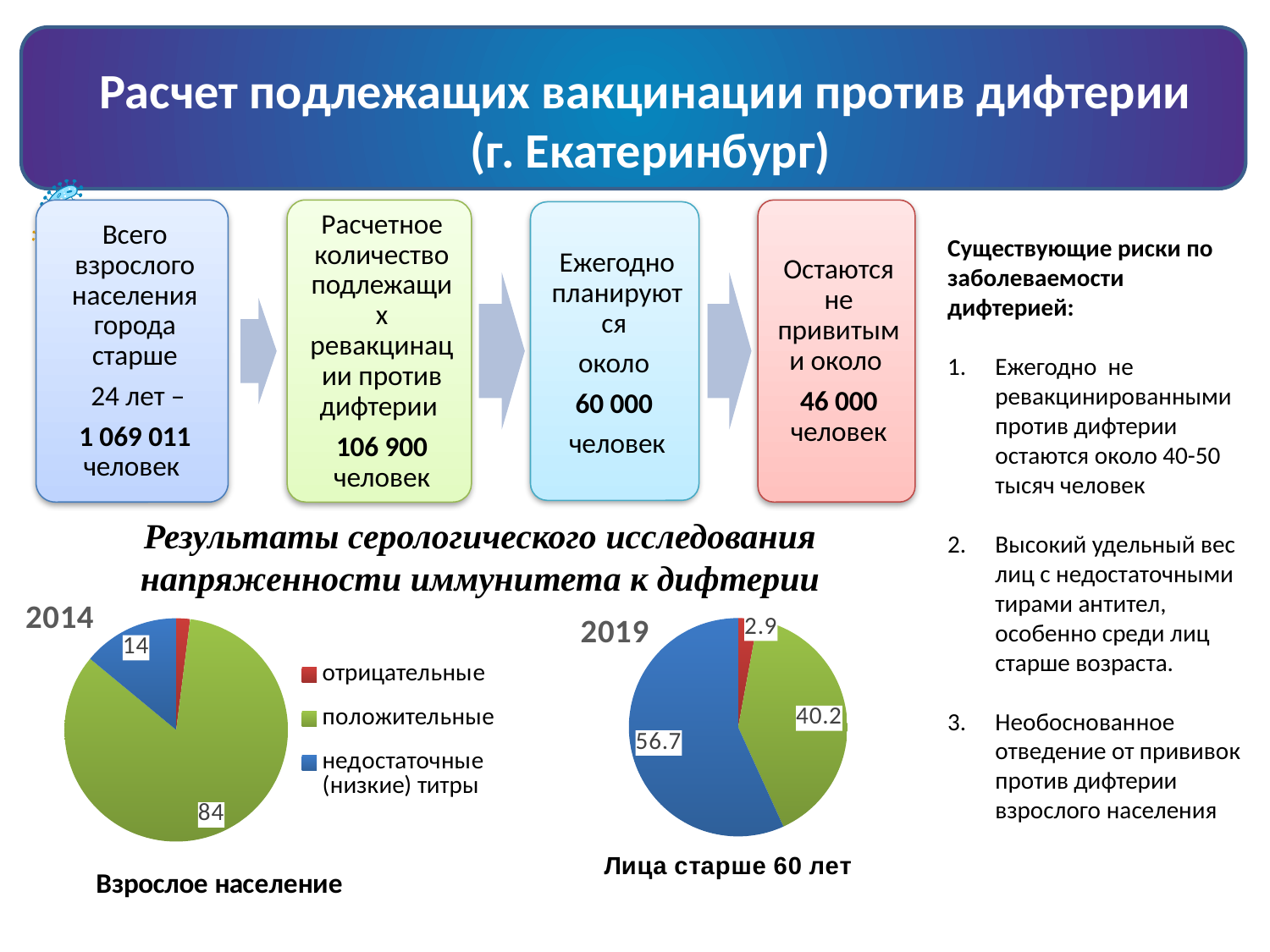
In the 2019 pie chart (Лица старше 60 лет), what value is shown for недостаточные (низкие) титры? 56.7 In the 2014 pie chart (Взрослое население), what value is shown for недостаточные (низкие) титры? 14 In the 2019 pie chart (Лица старше 60 лет), what value is shown for отрицательные? 2.9 Which is larger in the 2019 pie chart (Лица старше 60 лет): положительные or отрицательные? положительные In the 2014 pie chart (Взрослое население), what is the difference between the values for положительные and недостаточные (низкие) титры? 70 How many categories does the legend of the pie charts list? 3 In the 2014 pie chart (Взрослое население), what value is shown for положительные? 84 In the 2019 pie chart (Лица старше 60 лет), what is the difference between the values for недостаточные (низкие) титры and положительные? 16.5 In the 2019 pie chart (Лица старше 60 лет), what value is shown for положительные? 40.2 In the 2019 pie chart (Лица старше 60 лет), which category has the largest slice? недостаточные (низкие) титры What type of chart is used for the 2014 and 2019 serological results? Pie chart In the 2014 pie chart (Взрослое население), which category has the smallest slice? отрицательные